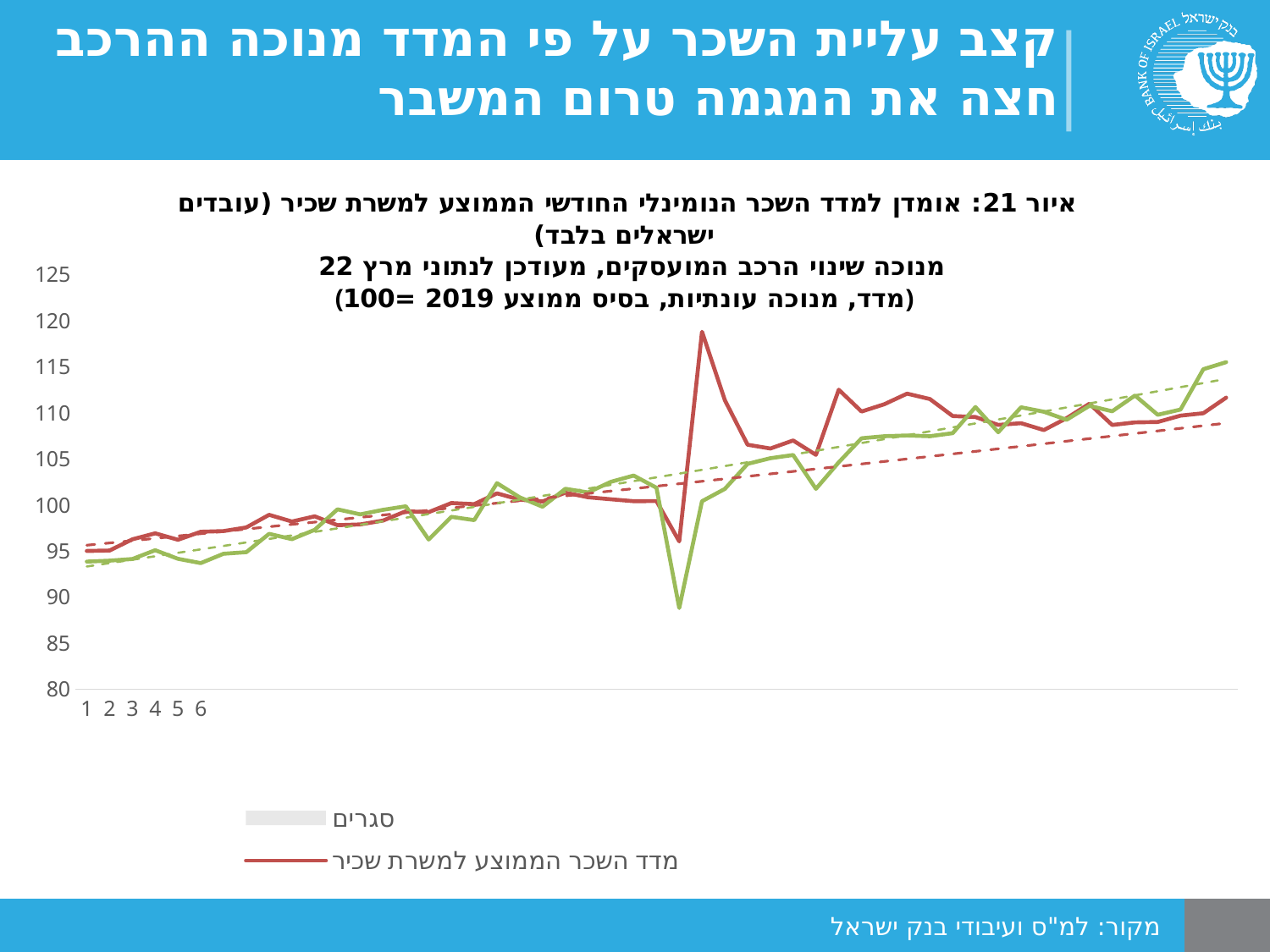
What is the figure number given in the chart title? איור 21 Overall, do the values of the red line rise or fall from left to right along the x axis? rise What is the highest value shown on the vertical axis? 125 According to the chart title, what base period is set to 100 for the index? ממוצע 2019 What kind of chart is shown on the slide? line chart Is the peak value of the red line (מדד השכר הממוצע למשרת שכיר) greater or less than 115? greater Is the value of the green line at the end of the series greater or less than 110? greater Is the value of the red line at the start of the series greater or less than 100? less How many entries does the legend list? 2 At the sharp spike in the middle of the chart, which line reaches the higher value, the red line or the green line? the red line